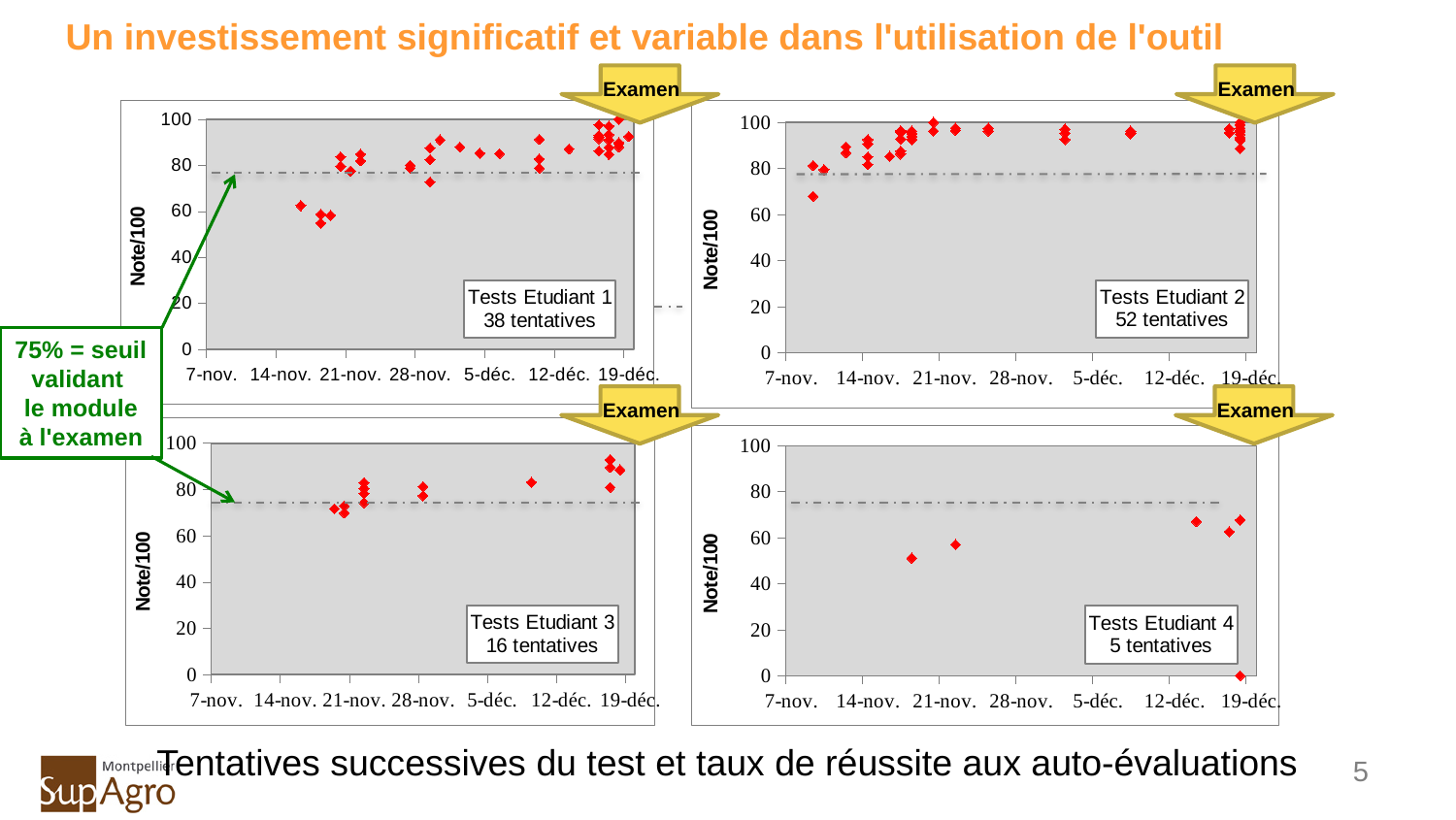
Which has more attempts, Tests Etudiant 3 or Tests Etudiant 1? Tests Etudiant 1 In the Tests Etudiant 3 chart, is the highest plotted score greater or less than 80? greater Which student's chart shows the fewest attempts? Tests Etudiant 4 According to the slide, what threshold does the dashed horizontal line on each chart represent? 75% = seuil validant le module à l'examen Which student's chart shows the most attempts? Tests Etudiant 2 How many attempts (tentatives) are shown in the Tests Etudiant 4 chart? 5 tentatives How many attempts (tentatives) are shown in the Tests Etudiant 2 chart? 52 tentatives How many more attempts does Tests Etudiant 2 show than Tests Etudiant 1? 14 In the Tests Etudiant 4 chart, is the highest plotted score greater or less than 80? less What kind of chart is used for Tests Etudiant 1? scatter chart In the Tests Etudiant 2 chart, do the scores generally rise or fall over time along the x axis? rise What is the label of the y axis on the four charts? Note/100